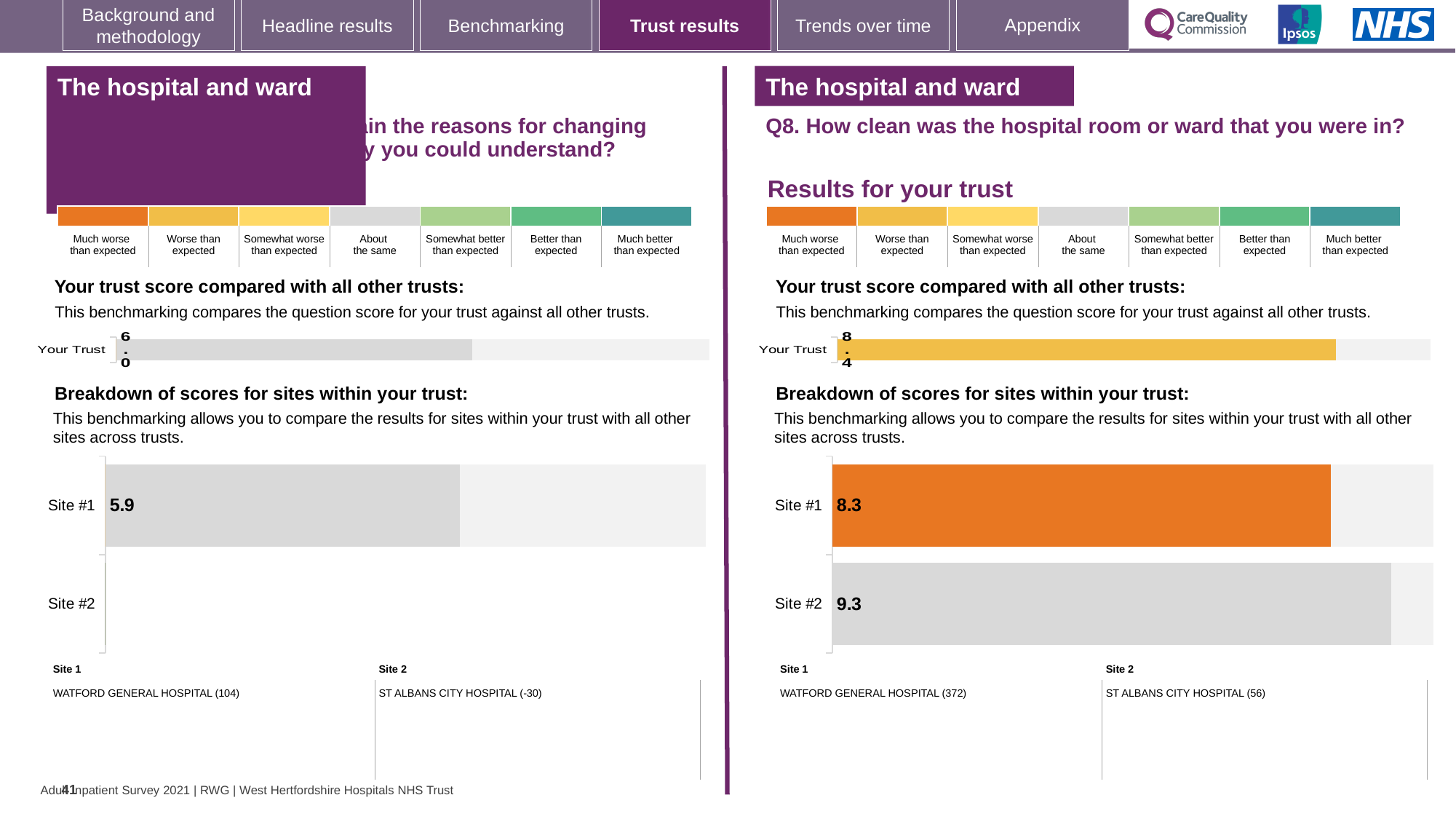
On the left-hand side of the slide, what is the 'Your Trust' score shown in the trust benchmarking bar? 6.0 On the right-hand side of the slide (Q8), what is the difference between the Site #2 score and the Site #1 score? 1.0 On the right-hand side of the slide (Q8. How clean was the hospital room or ward that you were in?), what is the 'Your Trust' score shown in the trust benchmarking bar? 8.4 On the left-hand side of the slide, how many sites are listed in the breakdown of scores for sites within your trust? 2 On the right-hand side of the slide (Q8), what score is shown for Site #1 in the breakdown of scores for sites within your trust? 8.3 On the right-hand side of the slide (Q8), is the Site #1 score larger or smaller than the Site #2 score? smaller What kind of chart is used for the breakdown of scores for sites within your trust on the right-hand side of the slide? Bar chart On the right-hand side of the slide (Q8), which hospital is listed as Site 1 below the site breakdown chart? WATFORD GENERAL HOSPITAL (372) On the right-hand side of the slide (Q8), which site has the higher score in the breakdown of scores for sites within your trust? Site #2 On the right-hand side of the slide (Q8), what colour is the Site #1 bar in the breakdown of scores for sites within your trust? Orange On the left-hand side of the slide, what score is shown for Site #1 in the breakdown of scores for sites within your trust? 5.9 On the right-hand side of the slide (Q8), what score is shown for Site #2 in the breakdown of scores for sites within your trust? 9.3